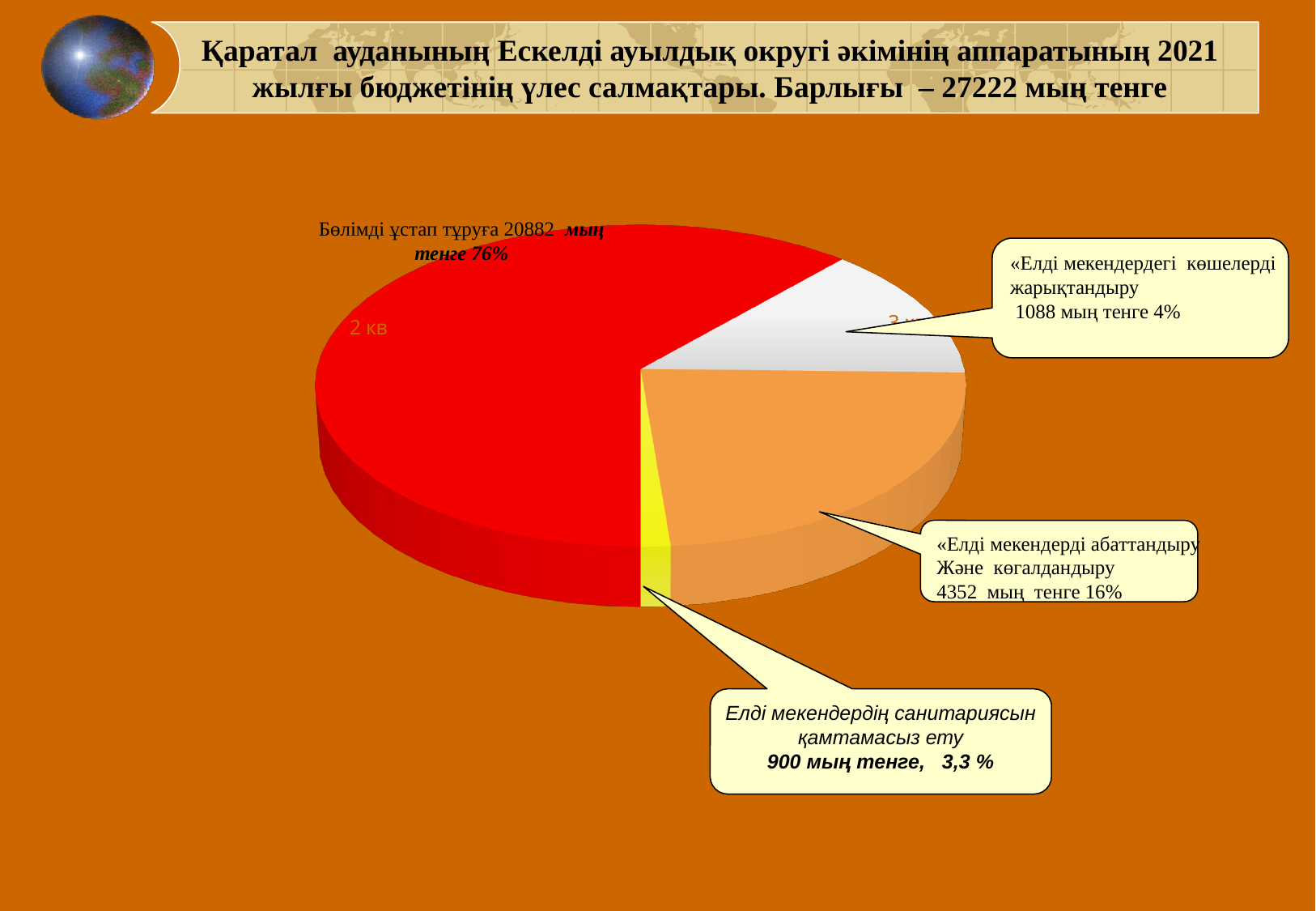
How many slices does the pie chart have? 4 What is the difference in мың тенге between "Елді мекендерді абаттандыру және көгалдандыру" (4352) and "Елді мекендердегі көшелерді жарықтандыру" (1088)? 3264 мың тенге What share of the budget goes to "Бөлімді ұстап тұруға"? 76% Which category has the largest slice of the pie? Бөлімді ұстап тұруға What amount is shown for "Елді мекендердегі көшелерді жарықтандыру"? 1088 мың тенге Which category has the smallest slice of the pie? Елді мекендердің санитариясын қамтамасыз ету What share of the pie is "Елді мекендердің санитариясын қамтамасыз ету"? 3,3 % What amount is shown for "Елді мекендердің санитариясын қамтамасыз ету"? 900 мың тенге What share of the pie is "Елді мекендерді абаттандыру және көгалдандыру"? 16% Which is larger: the amount for "Елді мекендерді абаттандыру және көгалдандыру" or for "Елді мекендердегі көшелерді жарықтандыру"? Елді мекендерді абаттандыру және көгалдандыру What total budget amount is stated in the slide title? 27222 мың тенге What kind of chart is shown on the slide? pie chart